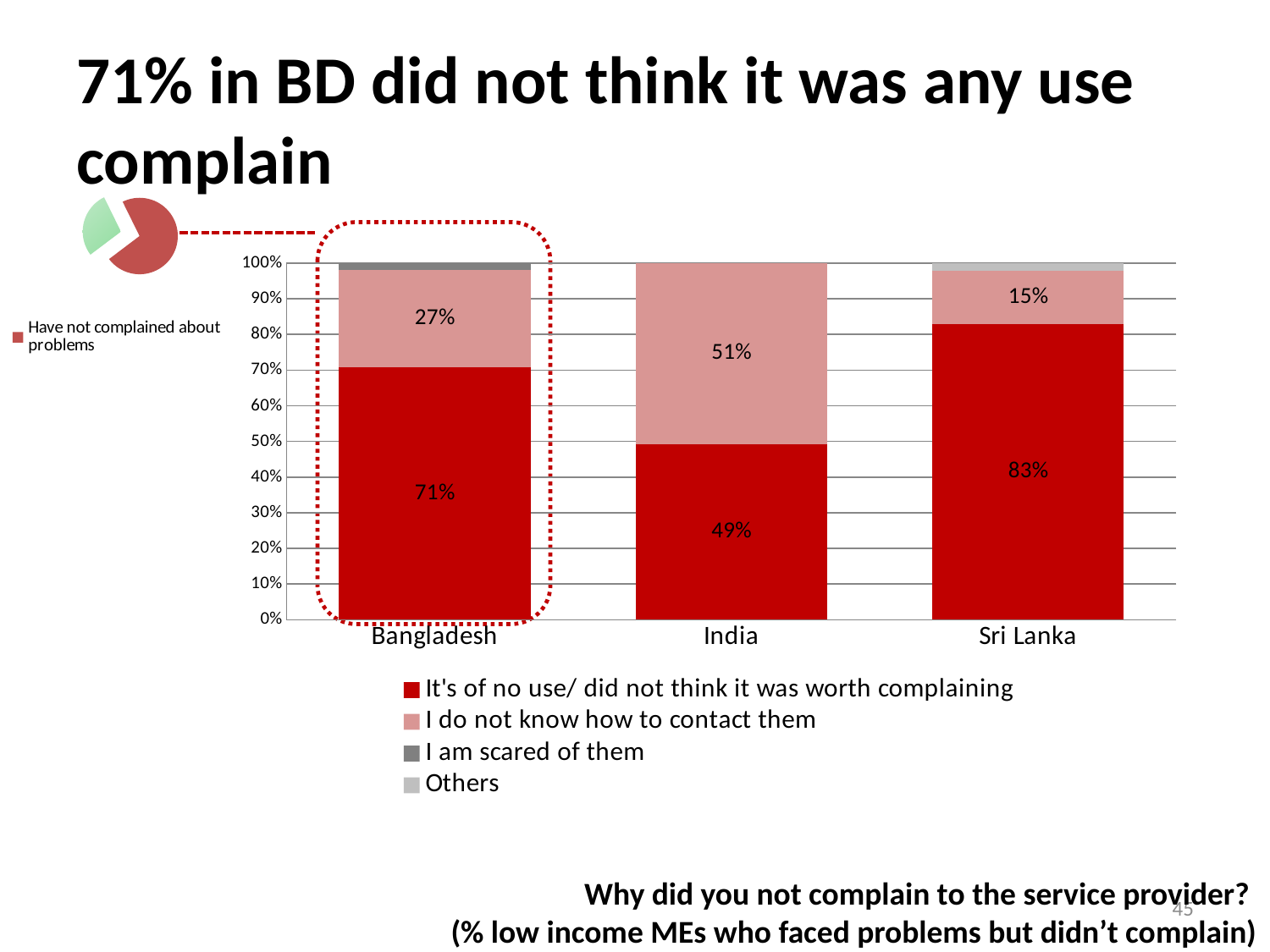
What type of chart is the main chart showing Bangladesh, India and Sri Lanka? Stacked bar chart In the stacked bar chart, what percentage of respondents in Sri Lanka said "It's of no use/ did not think it was worth complaining"? 83% In the stacked bar chart, how many percentage points higher is the "It's of no use" share in Sri Lanka than in Bangladesh? 12 percentage points In the stacked bar chart, for India, which is larger: "It's of no use/ did not think it was worth complaining" or "I do not know how to contact them"? I do not know how to contact them In the stacked bar chart, which country has the highest share for "It's of no use/ did not think it was worth complaining"? Sri Lanka In the stacked bar chart, is the value for India's "It's of no use/ did not think it was worth complaining" greater or less than 50%? less How many series does the legend of the stacked bar chart list? 4 In the stacked bar chart, what percentage of respondents in India said "I do not know how to contact them"? 51% In the stacked bar chart, what percentage of respondents in Sri Lanka said "I do not know how to contact them"? 15% In the stacked bar chart, what percentage of respondents in Bangladesh said "It's of no use/ did not think it was worth complaining"? 71% How many countries are shown on the x axis of the stacked bar chart? 3 In the stacked bar chart, which country has the lowest share for "It's of no use/ did not think it was worth complaining"? India